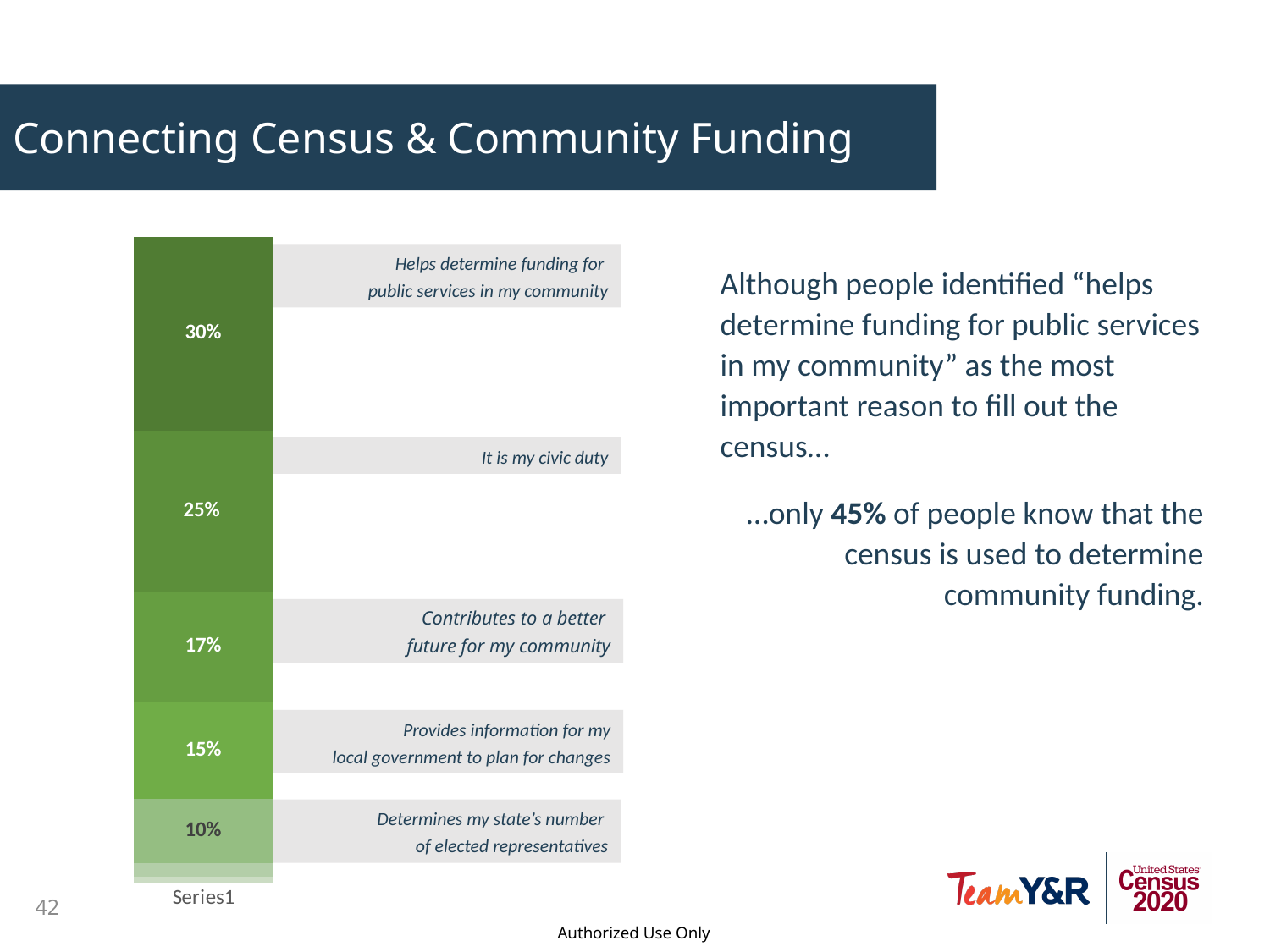
Which is larger: the value for "Contributes to a better future for my community" or the value for "Provides information for my local government to plan for changes"? Contributes to a better future for my community What percentage of people identified "Helps determine funding for public services in my community" as the most important reason? 30% Which reason has the lowest percentage in the chart? Determines my state's number of elected representatives What value is shown for "It is my civic duty"? 25% What is the difference between the percentages for "Helps determine funding for public services in my community" and "It is my civic duty"? 5 percentage points What value is shown for "Determines my state's number of elected representatives"? 10% Which reason has the highest percentage in the chart? Helps determine funding for public services in my community What label appears on the category axis beneath the stacked bar? Series1 What percentage is shown for "Provides information for my local government to plan for changes"? 15% What kind of chart is shown on the slide? Stacked bar chart